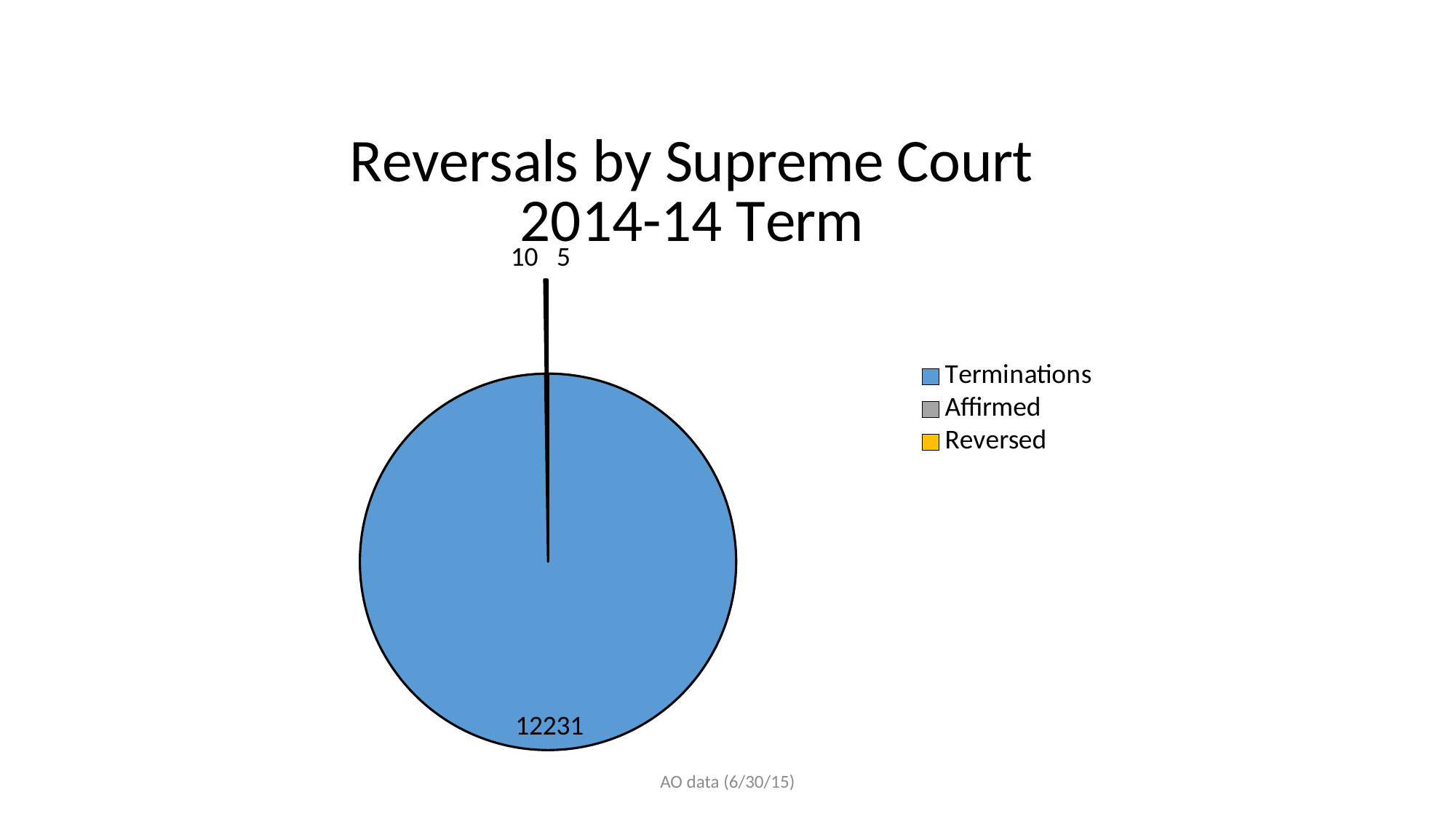
What colour is the Terminations slice? blue How many categories does the legend list? 3 What is the total of all values shown on the pie (12231, 10 and 5)? 12246 Which category has the largest slice of the pie? Terminations What is the value for Terminations? 12231 What is the title of the chart? Reversals by Supreme Court 2014-14 Term Which is larger, the Terminations value or the sum of the two small slices? Terminations What are the two small values labelled at the top of the pie? 10 and 5 Is the value for Terminations greater or less than 10000? greater What kind of chart is shown on the slide? pie chart